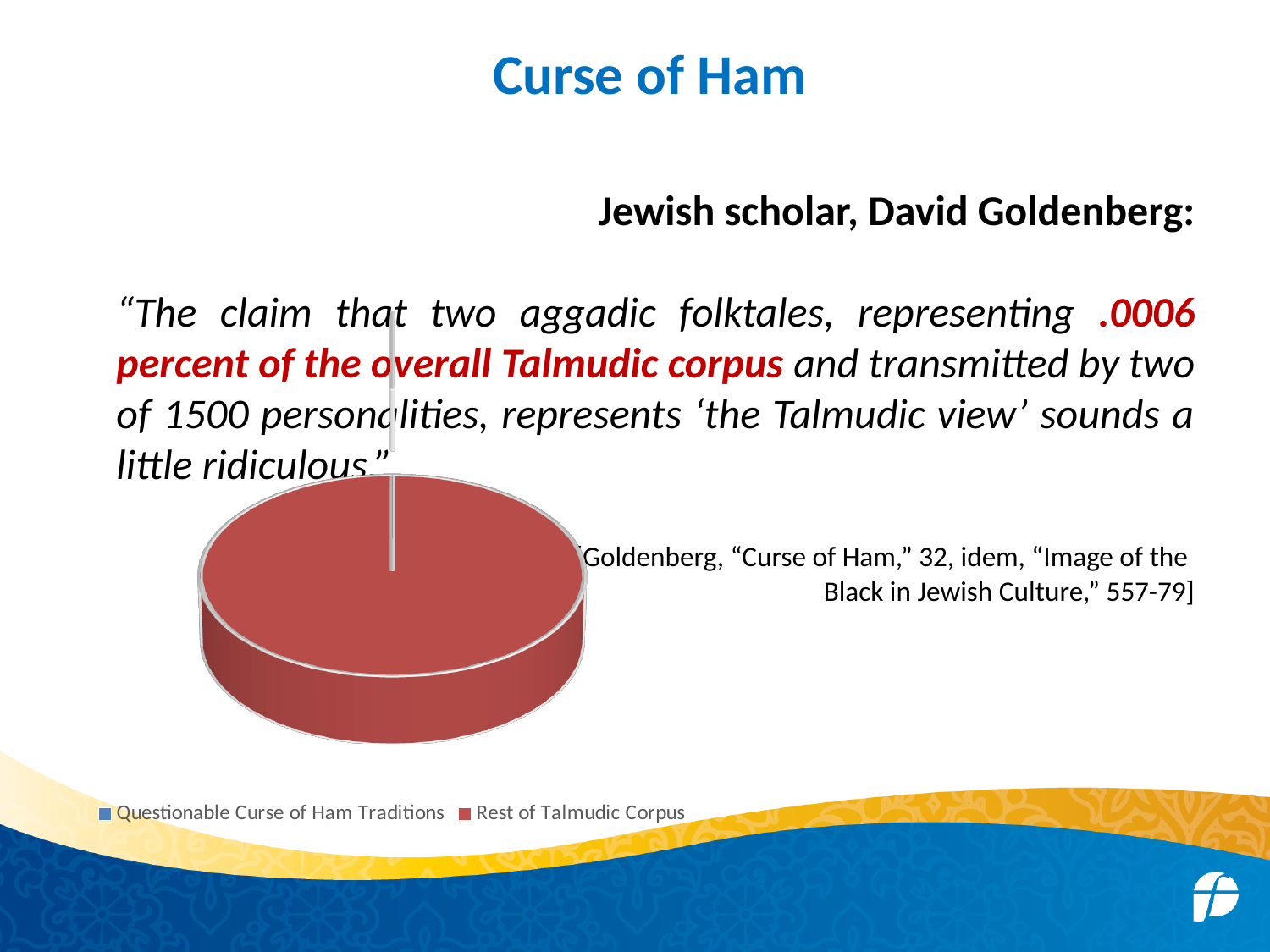
How many entries are in the pie chart's legend? 2 How many categories does the pie chart's legend list? 2 Which category takes up the largest share of the pie chart? Rest of Talmudic Corpus Which category takes up the smallest share of the pie chart? Questionable Curse of Ham Traditions What colour represents Questionable Curse of Ham Traditions in the pie chart's legend? blue What kind of chart is shown on the slide? pie chart Which is larger in the pie chart: Questionable Curse of Ham Traditions or Rest of Talmudic Corpus? Rest of Talmudic Corpus What colour represents Rest of Talmudic Corpus in the pie chart? red